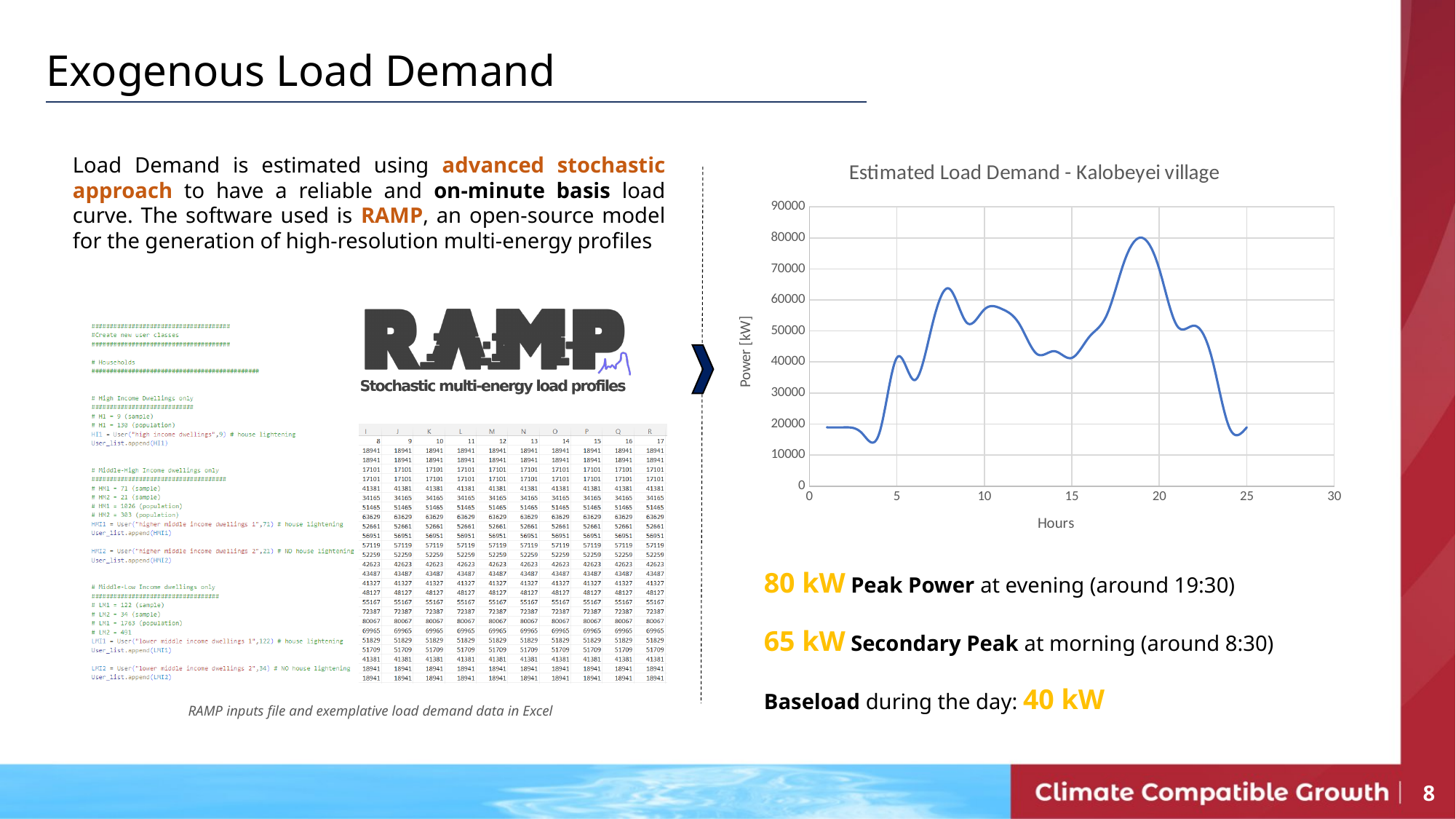
How many lines (series) are plotted on the chart? 1 Between hour 19 and hour 24, does the curve rise or fall? fall Is the value of the curve at hour 15 greater or less than 50000? less What is the title of the chart on the slide? Estimated Load Demand - Kalobeyei village Which is larger, the value of the curve at hour 19 or at hour 8? hour 19 Is the value of the curve at hour 1 greater or less than 30000? less Is the highest point of the curve closer to hour 10 or to hour 20? hour 20 Is the value of the curve at hour 4 greater or less than 20000? less What kind of chart is shown on the slide? line chart What is the label of the y axis of the chart? Power [kW]